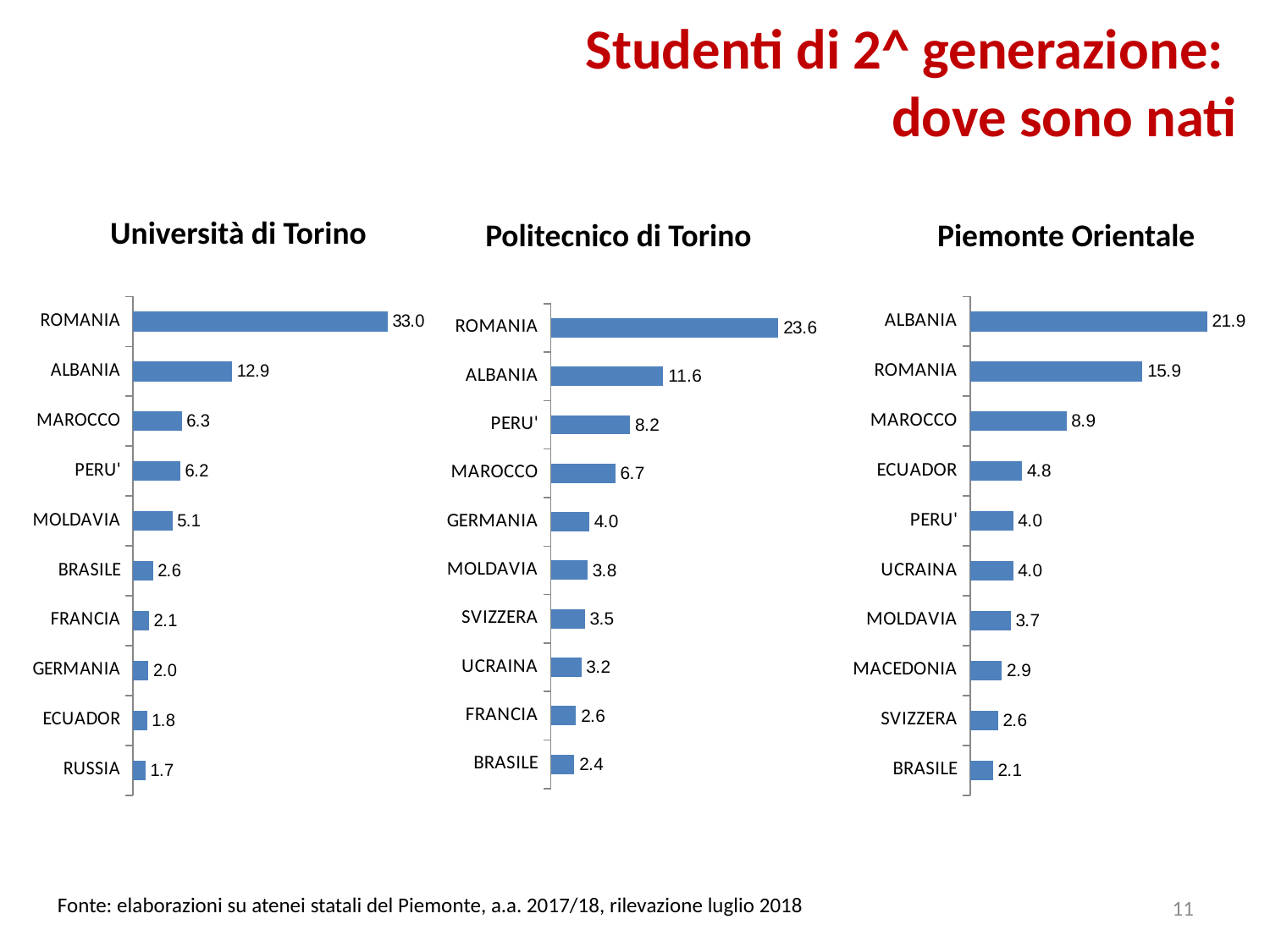
In the Università di Torino chart, what is the difference between the values for ROMANIA and ALBANIA? 20.1 In the Politecnico di Torino chart, which is larger, the value for GERMANIA or the value for SVIZZERA? GERMANIA How many categories are shown in the Università di Torino chart? 10 In the Politecnico di Torino chart, what is the value for PERU'? 8.2 In the Politecnico di Torino chart, which category has the lowest value? BRASILE In the Piemonte Orientale chart, what is the difference between the values for ALBANIA and ROMANIA? 6.0 What kind of chart is the Politecnico di Torino chart? Bar chart How many charts are shown on the slide? 3 In the Università di Torino chart, what is the value for ROMANIA? 33.0 In the Piemonte Orientale chart, which category has the highest value? ALBANIA In the Università di Torino chart, what is the value for MOLDAVIA? 5.1 In the Piemonte Orientale chart, what is the value for MAROCCO? 8.9